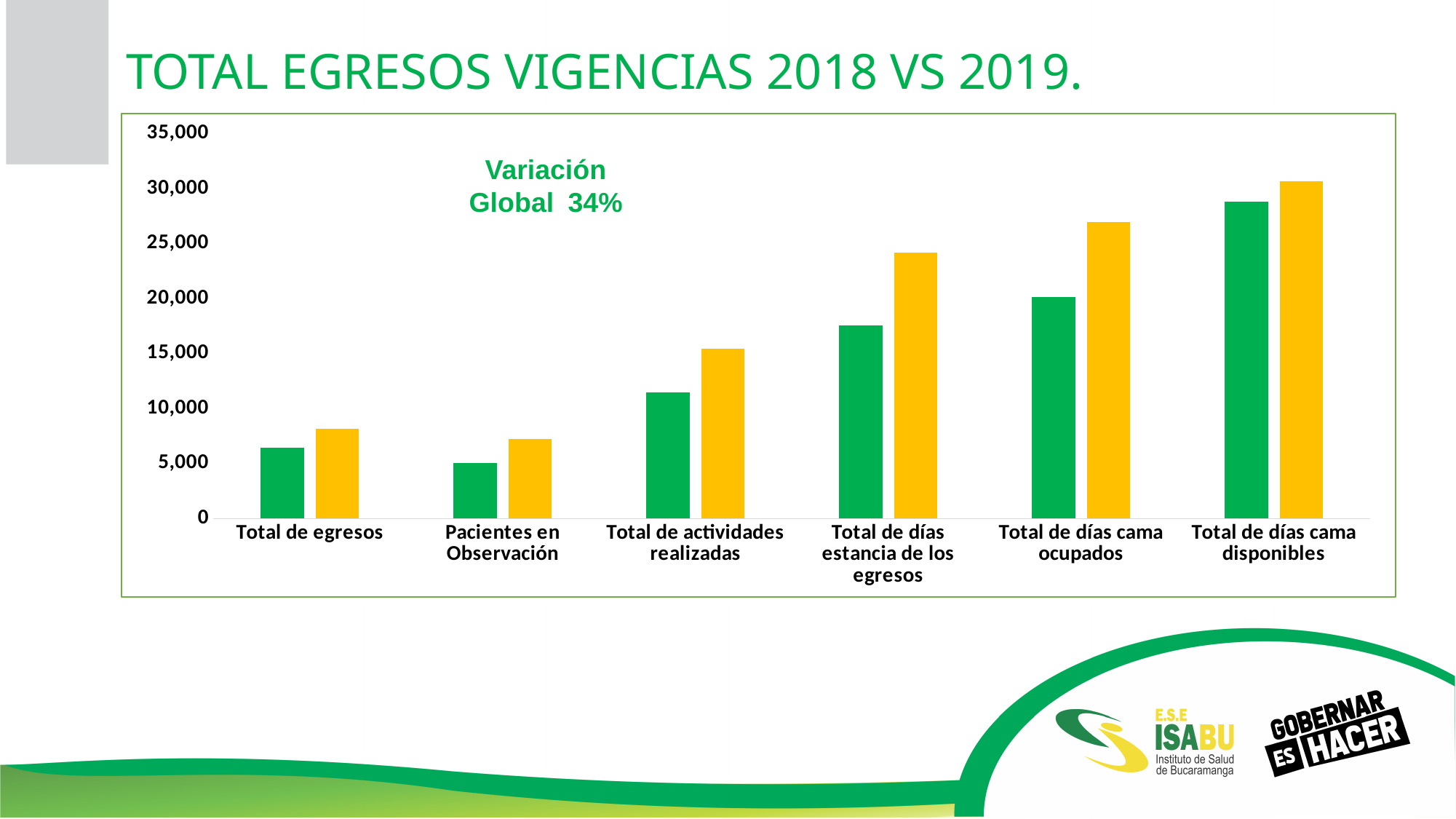
For Total de días estancia de los egresos, which bar is taller, the green one or the yellow one? the yellow one Is the green bar for Total de egresos greater or less than 10,000? less Do the bar heights generally rise or fall moving from left to right across the categories? rise Which category has the shortest bars in the chart? Pacientes en Observación Is the green bar for Total de actividades realizadas greater or less than 10,000? greater Is the yellow bar for Total de días cama ocupados greater or less than 25,000? greater What kind of chart is shown on the slide? bar chart What global variation percentage is annotated on the chart? 34% How many categories are shown along the x axis of the chart? 6 What is the title of the slide containing the chart? TOTAL EGRESOS VIGENCIAS 2018 VS 2019. Which category has the tallest bars in the chart? Total de días cama disponibles